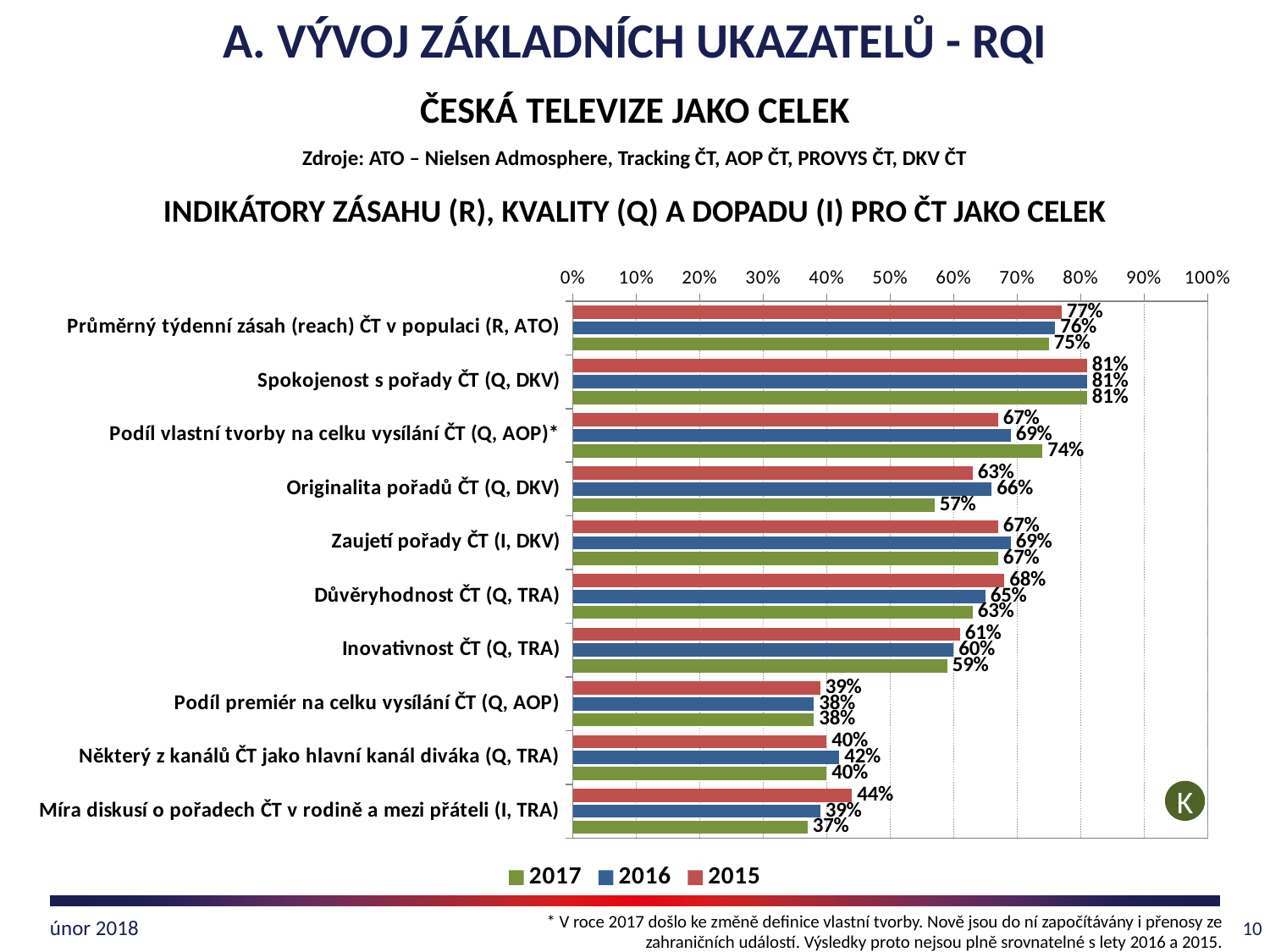
What is the 2016 value for Originalita pořadů ČT (Q, DKV)? 66% What is the difference between the 2017 and 2015 values for Podíl vlastní tvorby na celku vysílání ČT (Q, AOP)*? 7% What kind of chart is shown on the slide? bar chart For Důvěryhodnost ČT (Q, TRA), which year has the larger value, 2015 or 2017? 2015 Is the 2016 value for Podíl premiér na celku vysílání ČT (Q, AOP) greater or less than 50%? less What is the 2017 value for Spokojenost s pořady ČT (Q, DKV)? 81% How many series does the legend list? 3 How many categories (indicators) are plotted on the chart? 10 Which indicator has the highest 2017 value? Spokojenost s pořady ČT (Q, DKV) Which colour represents the 2017 series in the legend? green Which indicator has the lowest 2017 value? Míra diskusí o pořadech ČT v rodině a mezi přáteli (I, TRA) What is the 2015 value for Míra diskusí o pořadech ČT v rodině a mezi přáteli (I, TRA)? 44%